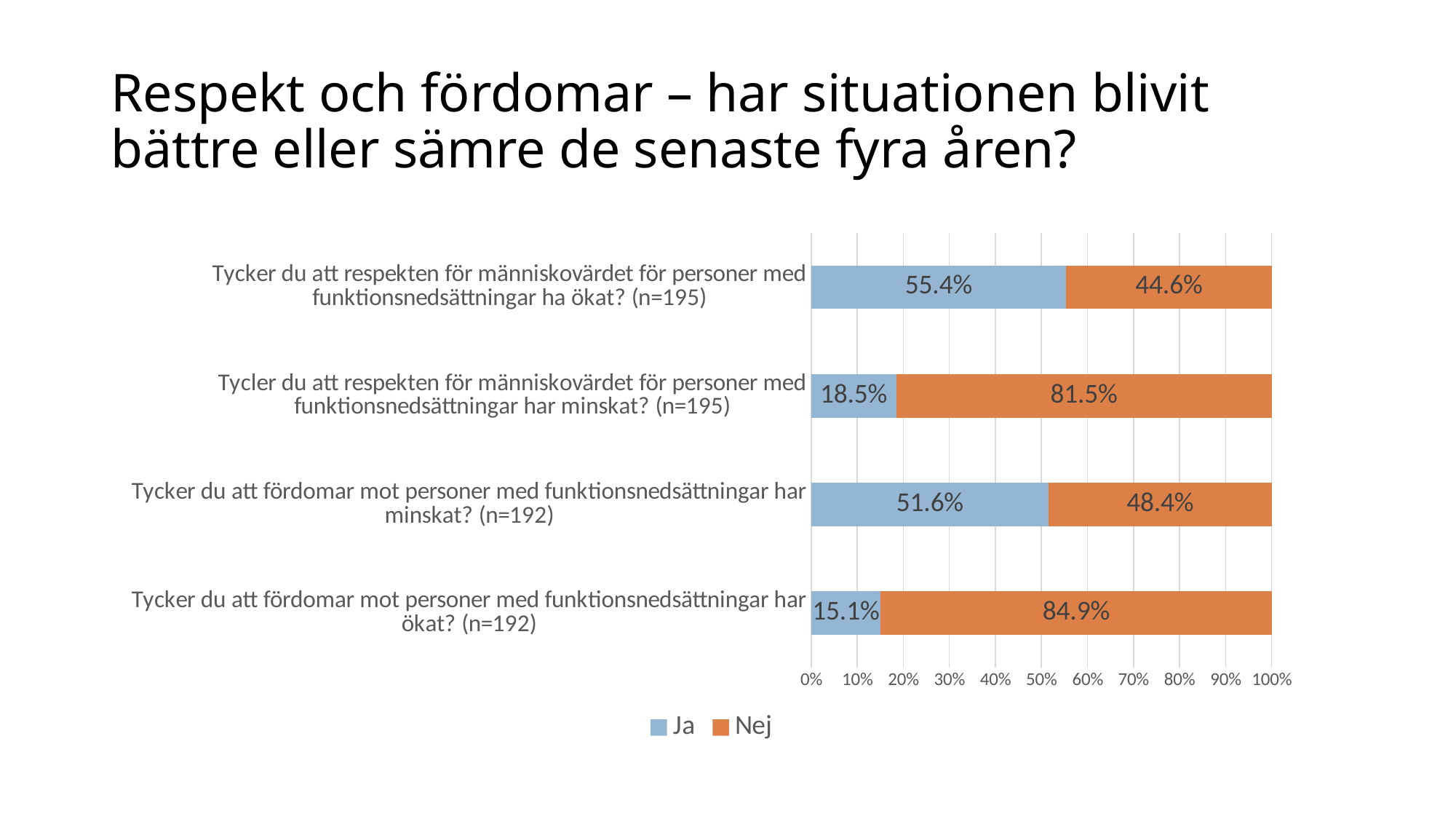
How many categories are shown on the chart? 4 Which category has the highest 'Nej' value? Tycker du att fördomar mot personer med funktionsnedsättningar har ökat? (n=192) What is the difference between the 'Nej' and 'Ja' values for 'Tycler du att respekten för människovärdet för personer med funktionsnedsättningar har minskat? (n=195)'? 63.0% What is the 'Nej' value for 'Tycler du att respekten för människovärdet för personer med funktionsnedsättningar har minskat? (n=195)'? 81.5% Which colour represents 'Nej' in the chart? Orange Which category has the lowest 'Ja' value? Tycker du att fördomar mot personer med funktionsnedsättningar har ökat? (n=192) What is the 'Ja' value for 'Tycker du att respekten för människovärdet för personer med funktionsnedsättningar ha ökat? (n=195)'? 55.4% What kind of chart is shown on the slide? Stacked bar chart What is the 'Nej' value for 'Tycker du att fördomar mot personer med funktionsnedsättningar har minskat? (n=192)'? 48.4% How many series does the legend list? 2 Which is larger: the 'Ja' value for 'Tycker du att respekten för människovärdet för personer med funktionsnedsättningar ha ökat? (n=195)' or the 'Ja' value for 'Tycker du att fördomar mot personer med funktionsnedsättningar har minskat? (n=192)'? Tycker du att respekten för människovärdet för personer med funktionsnedsättningar ha ökat? (n=195) What is the 'Ja' value for 'Tycker du att fördomar mot personer med funktionsnedsättningar har ökat? (n=192)'? 15.1%